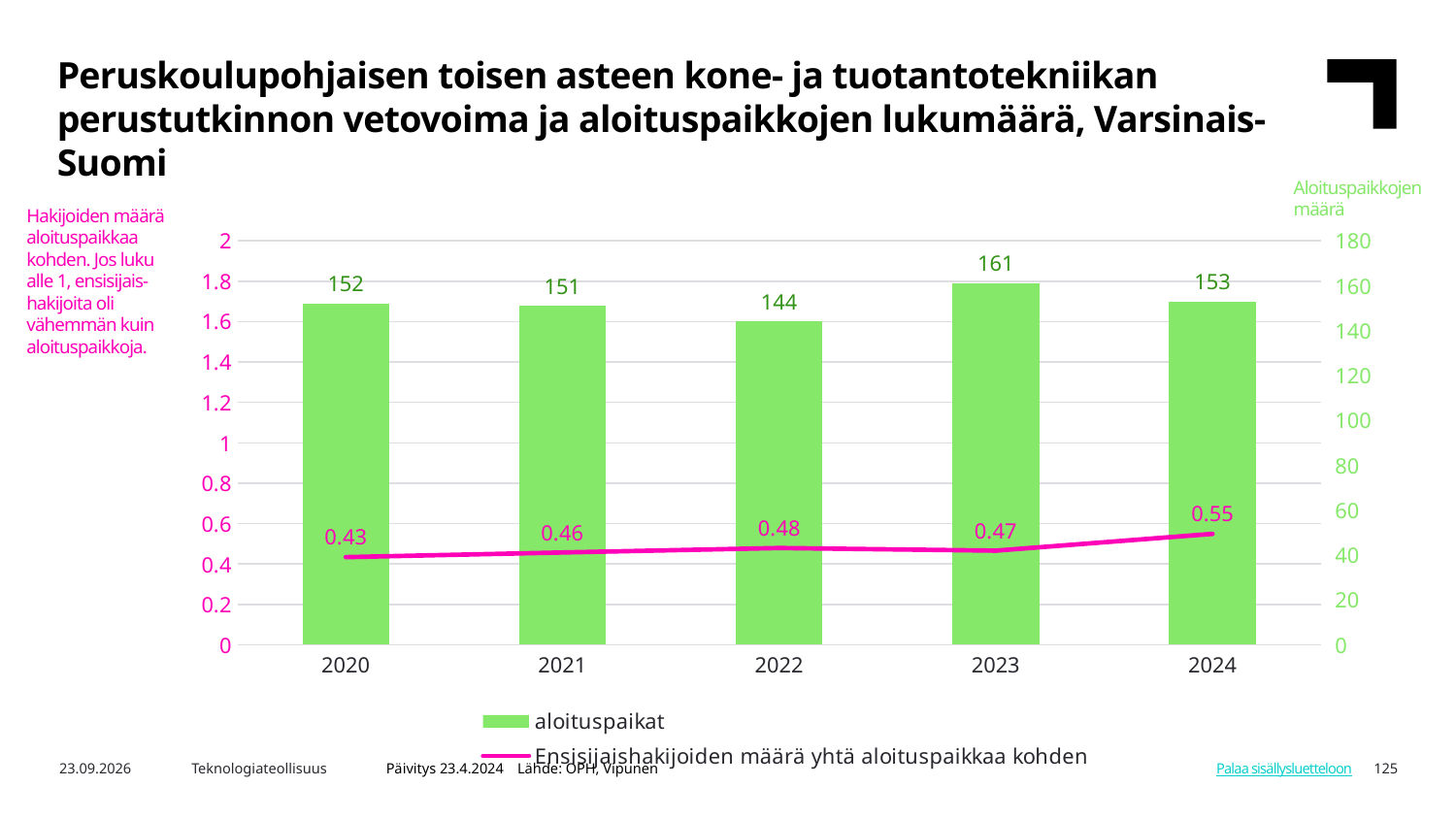
Which year has the highest value for aloituspaikat? 2023 What is the difference between the aloituspaikat values for 2023 and 2022? 17 How many series does the legend list? 2 How many years are shown on the x axis? 5 What is the value of aloituspaikat for 2023? 161 Does the Ensisijaishakijoiden määrä yhtä aloituspaikkaa kohden line rise or fall from 2023 to 2024? rise What colour are the aloituspaikat bars? green Which year has a larger aloituspaikat value, 2020 or 2024? 2024 What is the value of Ensisijaishakijoiden määrä yhtä aloituspaikkaa kohden for 2024? 0.55 Which year has the lowest value for Ensisijaishakijoiden määrä yhtä aloituspaikkaa kohden? 2020 What kind of chart is used for the aloituspaikat series? bar chart What is the value of aloituspaikat for 2022? 144